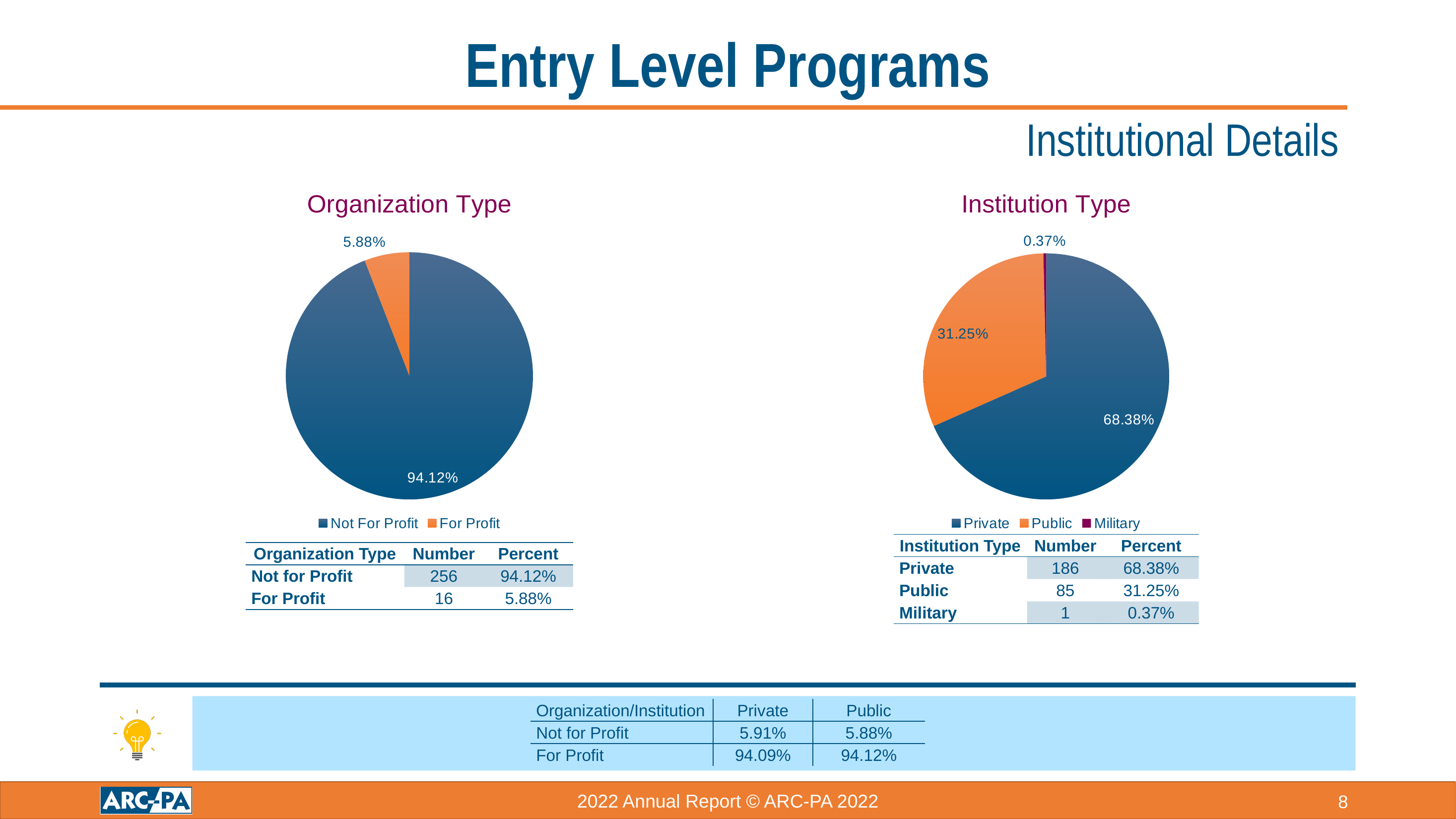
In the Organization Type chart, which is larger, Not For Profit or For Profit? Not For Profit What kind of chart is the Organization Type chart? Pie chart In the Institution Type chart, what share of the pie is Public? 31.25% In the Institution Type chart, what is the difference in percentage points between Private and Public? 37.13 In the Institution Type chart, what share of the pie is Military? 0.37% In the Organization Type chart, what share of the pie is Not For Profit? 94.12% How many entries does the legend of the Organization Type chart list? 2 In the Institution Type chart, what colour is the Public slice? Orange In the Institution Type chart, which category has the largest slice? Private How many categories does the Institution Type chart show? 3 In the Institution Type chart, which category has the smallest slice? Military